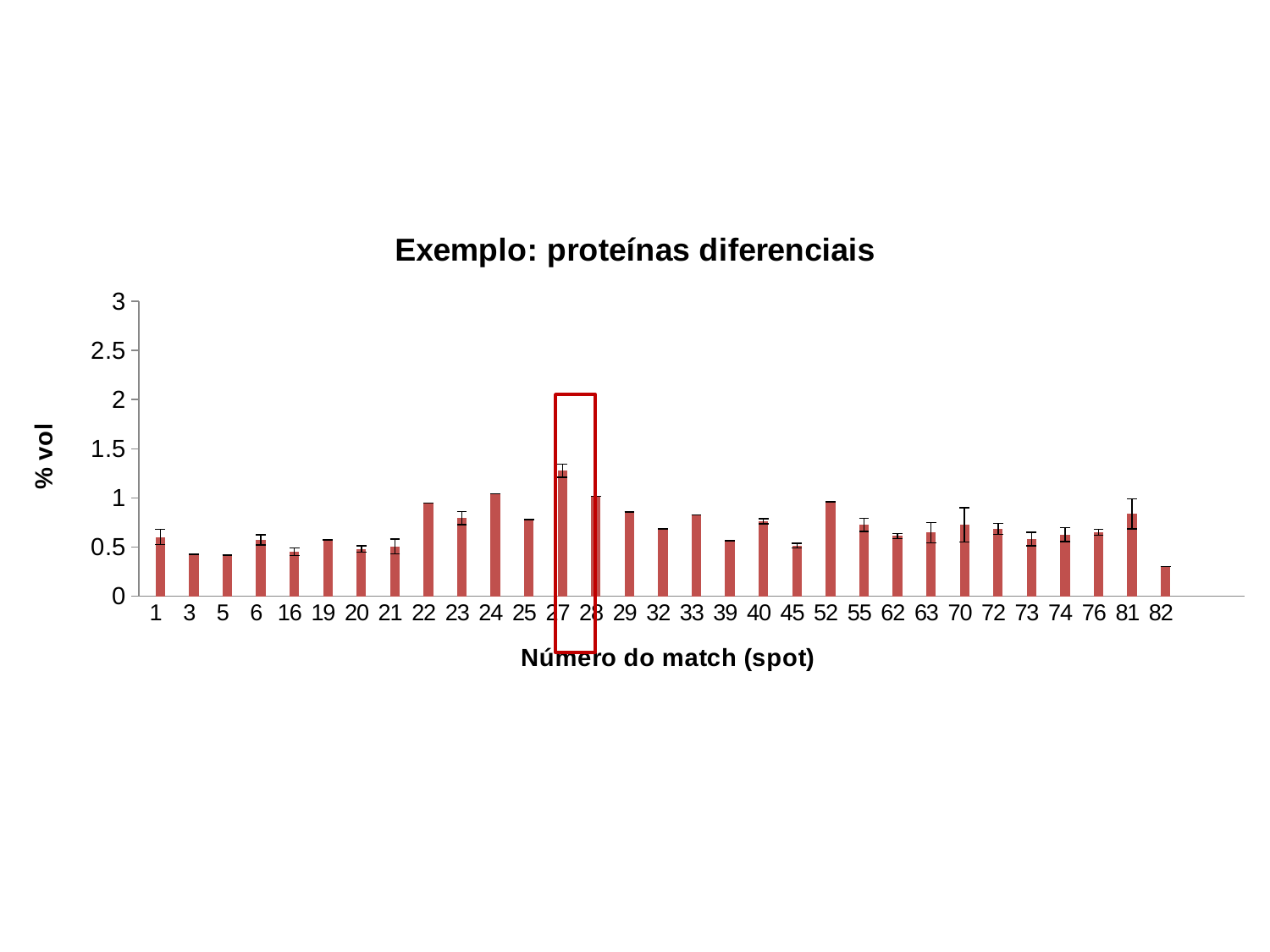
What is the label of the vertical axis? % vol What kind of chart is shown on the slide? Bar chart Is the value for spot 82 greater or less than 0.5? less Which has a larger % vol, spot 22 or spot 3? Spot 22 Which spot number has the lowest % vol? 82 Which spot number has the highest % vol? 27 Is the value for spot 3 greater or less than 0.5? less Is the value for spot 27 greater or less than 1? greater Which has a larger % vol, spot 5 or spot 24? Spot 24 How many spot categories are shown on the x axis? 31 What is the title of the chart? Exemplo: proteínas diferenciais